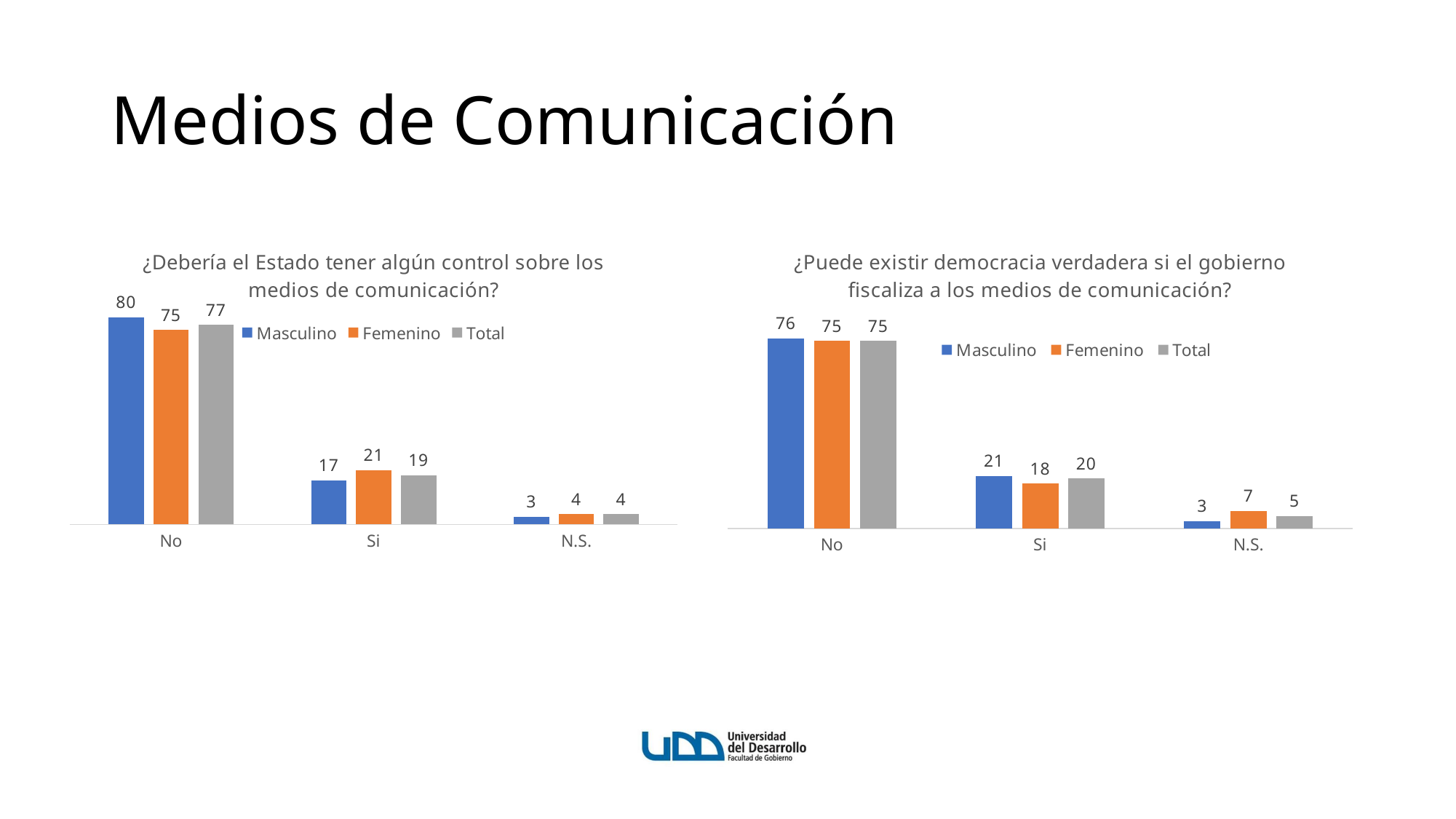
In the right chart (¿Puede existir democracia verdadera si el gobierno fiscaliza a los medios de comunicación?), what is the difference between the Masculino and Femenino values for Si? 3 In the right chart (¿Puede existir democracia verdadera si el gobierno fiscaliza a los medios de comunicación?), what is the Femenino value for N.S.? 7 In the left chart (¿Debería el Estado tener algún control sobre los medios de comunicación?), what is the Femenino value for Si? 21 In the left chart (¿Debería el Estado tener algún control sobre los medios de comunicación?), what is the Masculino value for No? 80 What kind of chart is the right chart (¿Puede existir democracia verdadera si el gobierno fiscaliza a los medios de comunicación?)? Bar chart How many series does the legend of the left chart (¿Debería el Estado tener algún control sobre los medios de comunicación?) list? 3 In the left chart (¿Debería el Estado tener algún control sobre los medios de comunicación?), which is larger for Si: the Masculino value or the Femenino value? Femenino In the right chart (¿Puede existir democracia verdadera si el gobierno fiscaliza a los medios de comunicación?), which category has the lowest Masculino value? N.S. In the left chart (¿Debería el Estado tener algún control sobre los medios de comunicación?), which category has the highest Total value? No In the left chart (¿Debería el Estado tener algún control sobre los medios de comunicación?), what is the difference between the Masculino and Femenino values for No? 5 In the right chart (¿Puede existir democracia verdadera si el gobierno fiscaliza a los medios de comunicación?), what is the Total value for Si? 20 How many categories are shown on the x axis of the right chart (¿Puede existir democracia verdadera si el gobierno fiscaliza a los medios de comunicación?)? 3